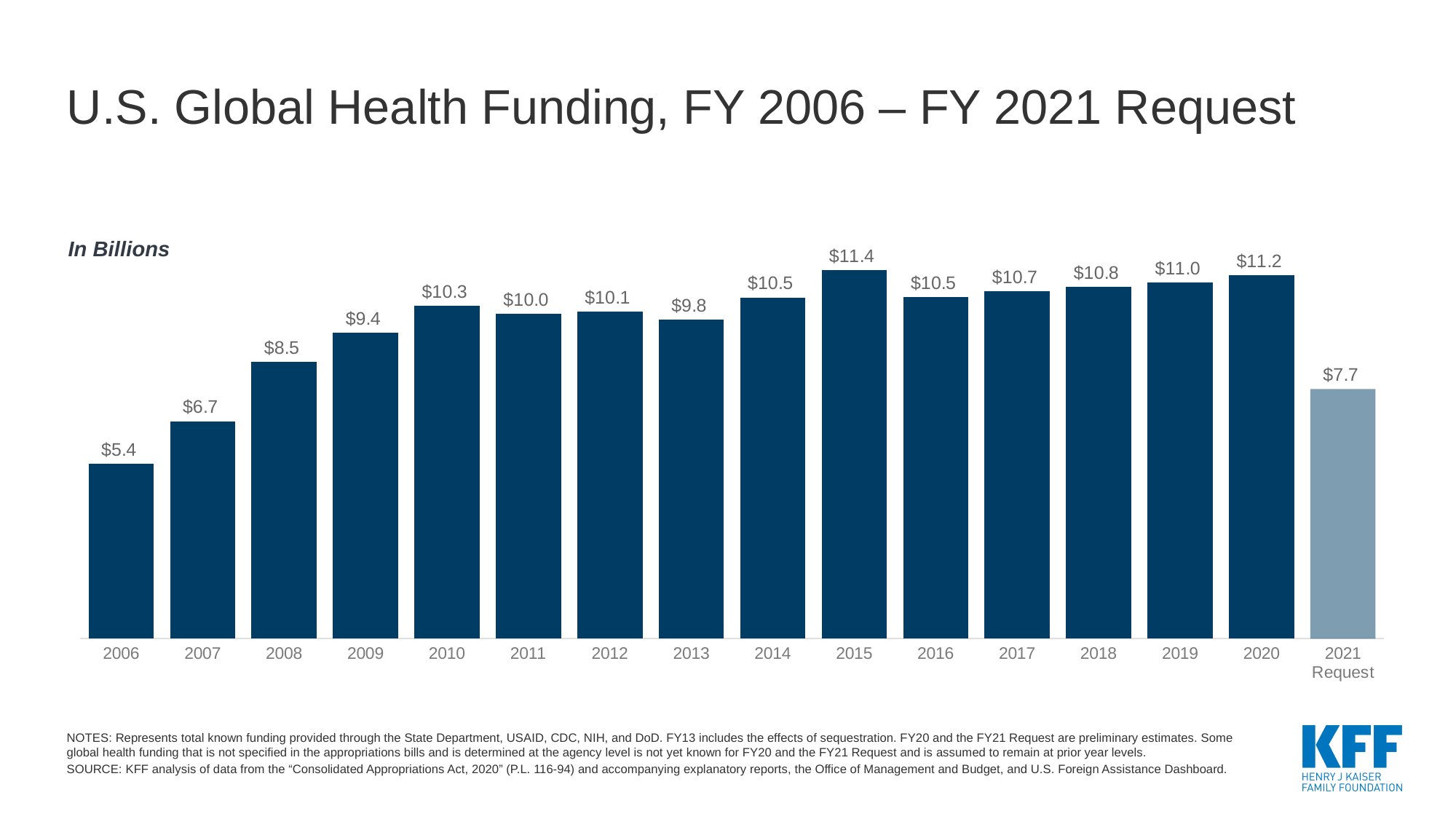
What is the funding value shown for 2006? $5.4 How many bars are shown on the chart? 16 Which year has the highest funding value on the chart? 2015 What is the difference between the 2015 value and the 2016 value? $0.9 Which year has the lowest funding value on the chart? 2006 In what units are the values on the chart expressed? In Billions What is the value shown for the 2021 Request? $7.7 Which is larger, the value for 2010 or the value for 2013? 2010 What is the U.S. global health funding value shown for 2015? $11.4 What is the difference between the 2020 value and the 2021 Request value? $3.5 Do the values rise or fall from 2006 to 2010? Rise What type of chart is shown on the slide? Bar chart